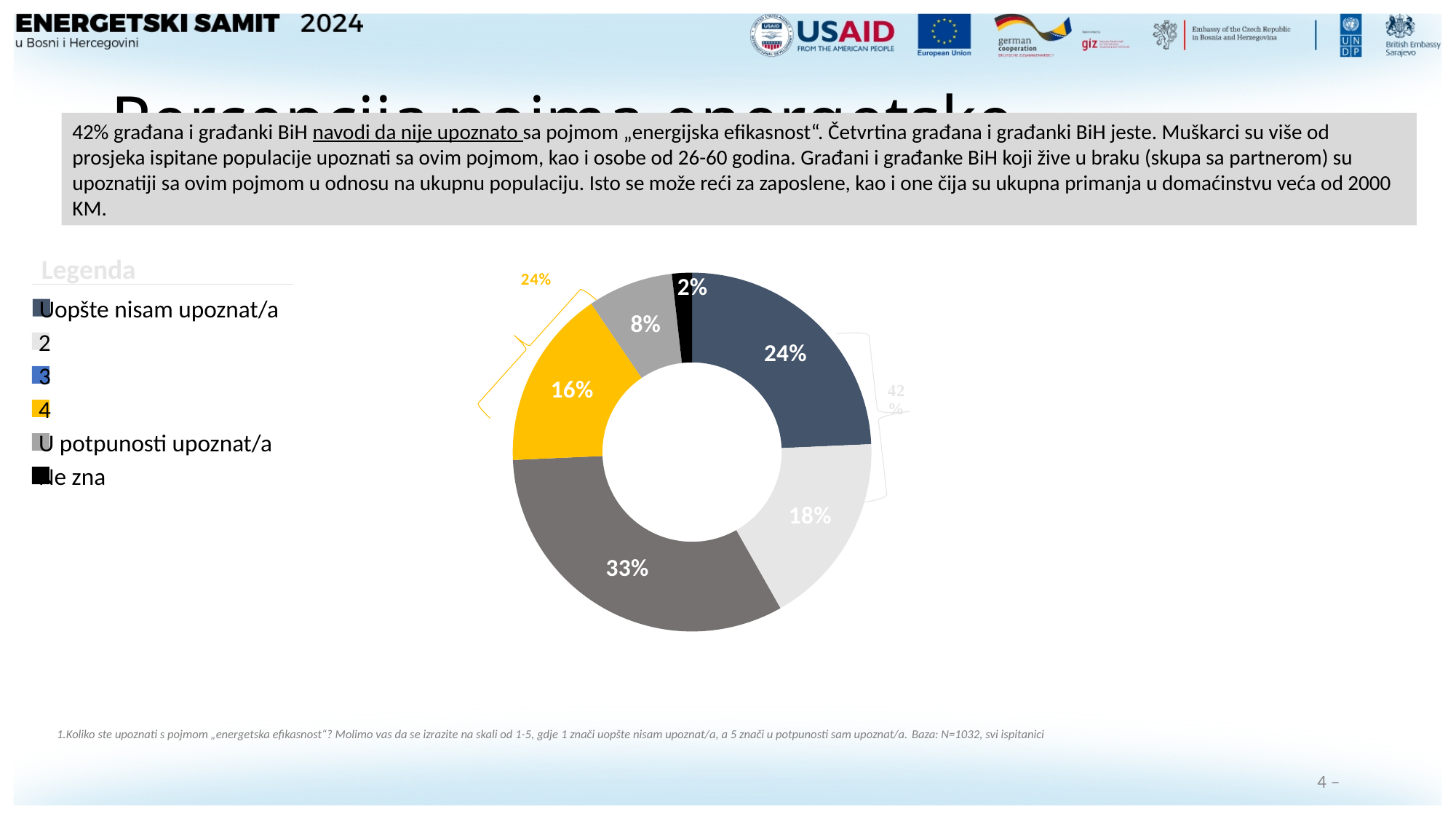
What share of respondents gave the answer "4"? 16% What share of respondents answered "U potpunosti upoznat/a"? 8% Which slice of the doughnut chart is the largest? 3 (33%) Which is larger: the "4" slice or the "U potpunosti upoznat/a" slice? 4 How many entries does the legend list? 6 What share of respondents gave the answer "2"? 18% Which category has the smallest slice in the doughnut chart? Ne zna What kind of chart is shown on the slide? doughnut (pie) chart How many slices does the doughnut chart have? 6 What is the difference in percentage points between the "Uopšte nisam upoznat/a" slice (24%) and the "2" slice (18%)? 6 percentage points